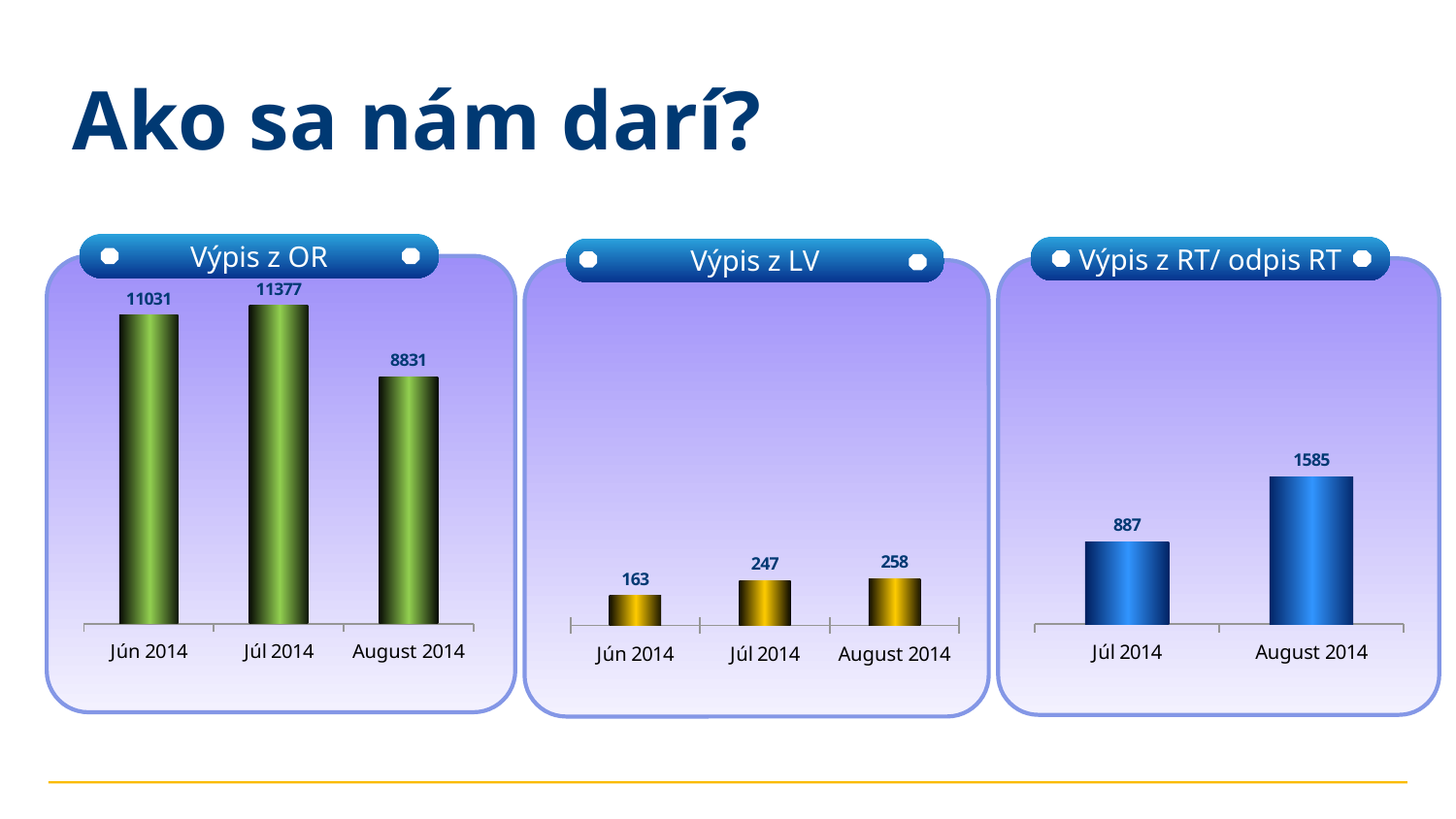
In the 'Výpis z LV' chart, which month has the highest value? August 2014 In the 'Výpis z OR' chart, which month has the lowest value? August 2014 In the 'Výpis z OR' chart, what is the value for Júl 2014? 11377 In the 'Výpis z LV' chart, what is the value for Jún 2014? 163 In the 'Výpis z OR' chart, what is the difference between Júl 2014 and August 2014? 2546 In the 'Výpis z RT/ odpis RT' chart, what is the difference between August 2014 and Júl 2014? 698 In the 'Výpis z OR' chart, which is larger, Jún 2014 or August 2014? Jún 2014 In the 'Výpis z LV' chart, do the values rise or fall from Jún 2014 to August 2014? rise What kind of chart is the 'Výpis z OR' chart? bar chart In the 'Výpis z RT/ odpis RT' chart, how many months are shown? 2 In the 'Výpis z RT/ odpis RT' chart, what is the value for August 2014? 1585 In the 'Výpis z LV' chart, how many months are shown? 3